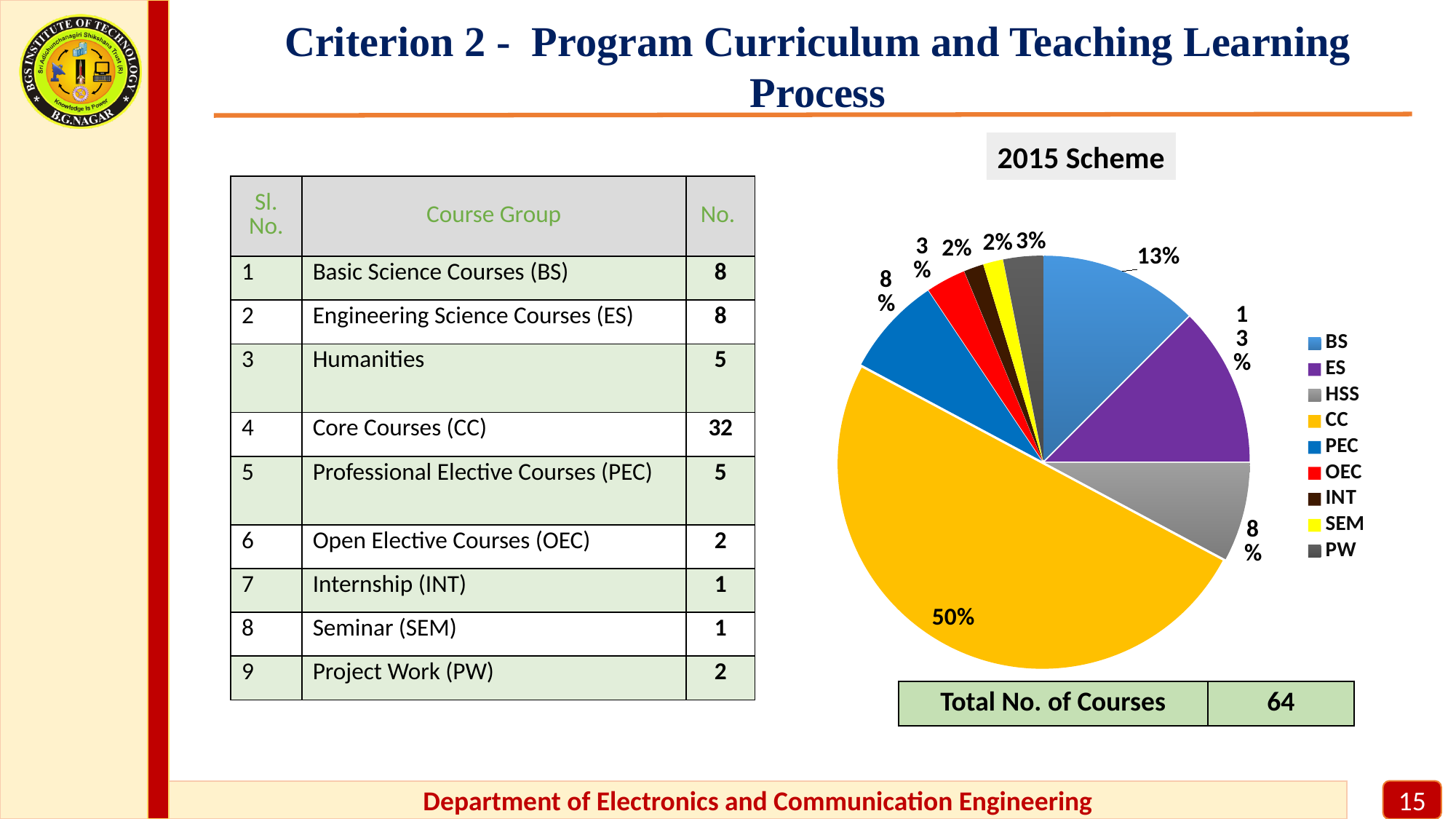
What is the difference in percentage points between the CC slice and the BS slice? 37 What is the title shown above the pie chart? 2015 Scheme What percentage of the pie chart does CC account for? 50% Which colour represents CC in the pie chart? orange (gold) What percentage is shown for HSS in the pie chart? 8% How many slices does the pie chart have? 9 What percentage is shown for BS in the pie chart? 13% What percentage is shown for PEC in the pie chart? 8% Which is larger in the pie chart, the share for CC or the share for ES? CC What kind of chart is shown on the slide? pie chart Which course group has the largest slice of the pie chart? CC How many entries does the pie chart's legend list? 9